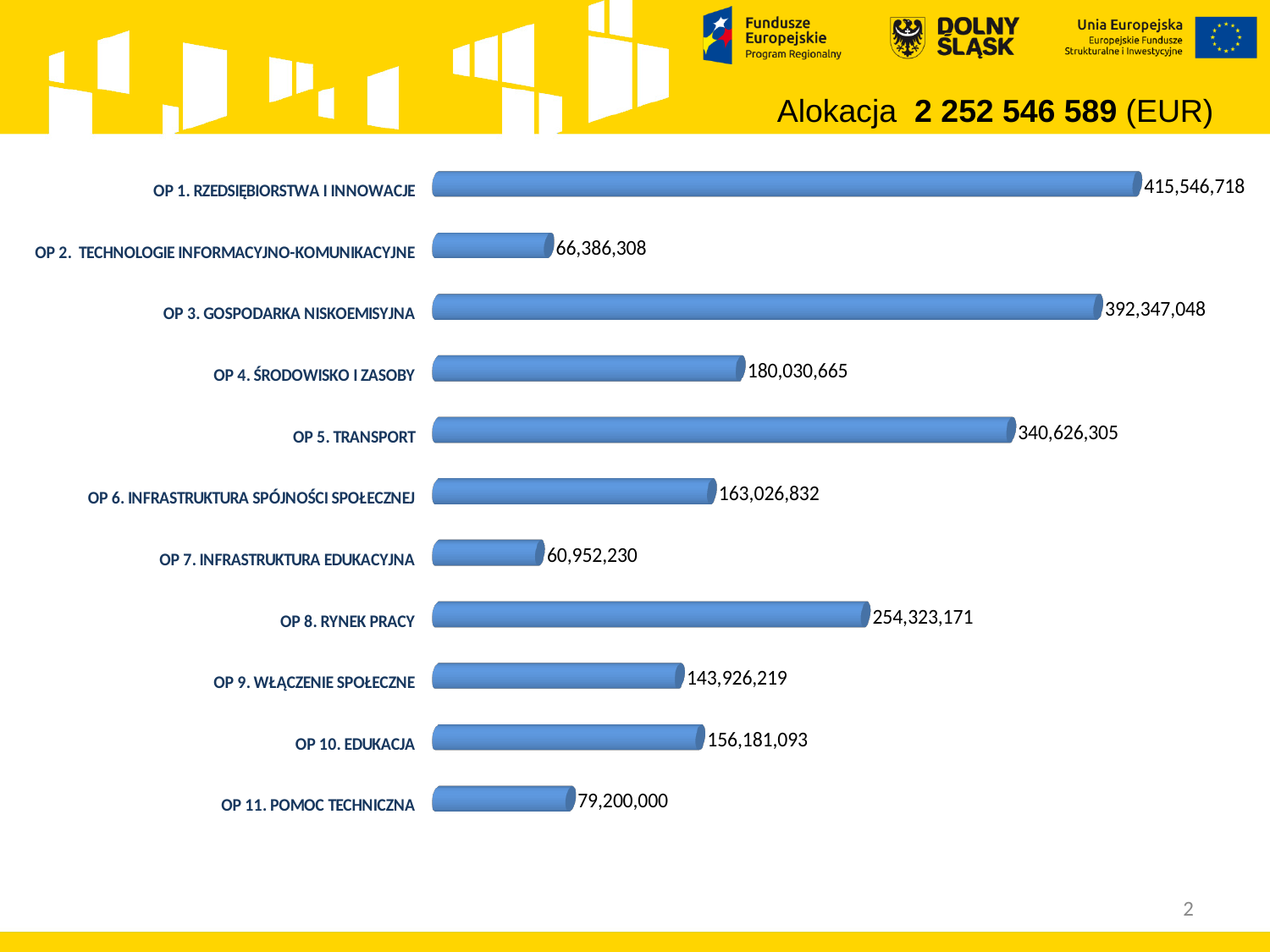
Which category has the lowest value? OP 7. INFRASTRUKTURA EDUKACYJNA How many categories are shown in the chart? 11 What kind of chart is shown on the slide? bar chart What is the value for OP 8. RYNEK PRACY? 254,323,171 Which category has the highest value? OP 1. RZEDSIĘBIORSTWA I INNOWACJE What is the difference between the values for OP 5. TRANSPORT and OP 8. RYNEK PRACY? 86,303,134 What is the value for OP 11. POMOC TECHNICZNA? 79,200,000 What is the value for OP 5. TRANSPORT? 340,626,305 Which is larger, the value for OP 4. ŚRODOWISKO I ZASOBY or the value for OP 6. INFRASTRUKTURA SPÓJNOŚCI SPOŁECZNEJ? OP 4. ŚRODOWISKO I ZASOBY Which is larger, the value for OP 2. TECHNOLOGIE INFORMACYJNO-KOMUNIKACYJNE or the value for OP 11. POMOC TECHNICZNA? OP 11. POMOC TECHNICZNA What is the difference between the values for OP 1. RZEDSIĘBIORSTWA I INNOWACJE and OP 3. GOSPODARKA NISKOEMISYJNA? 23,199,670 What total allocation (Alokacja) in EUR is stated in the slide heading? 2 252 546 589